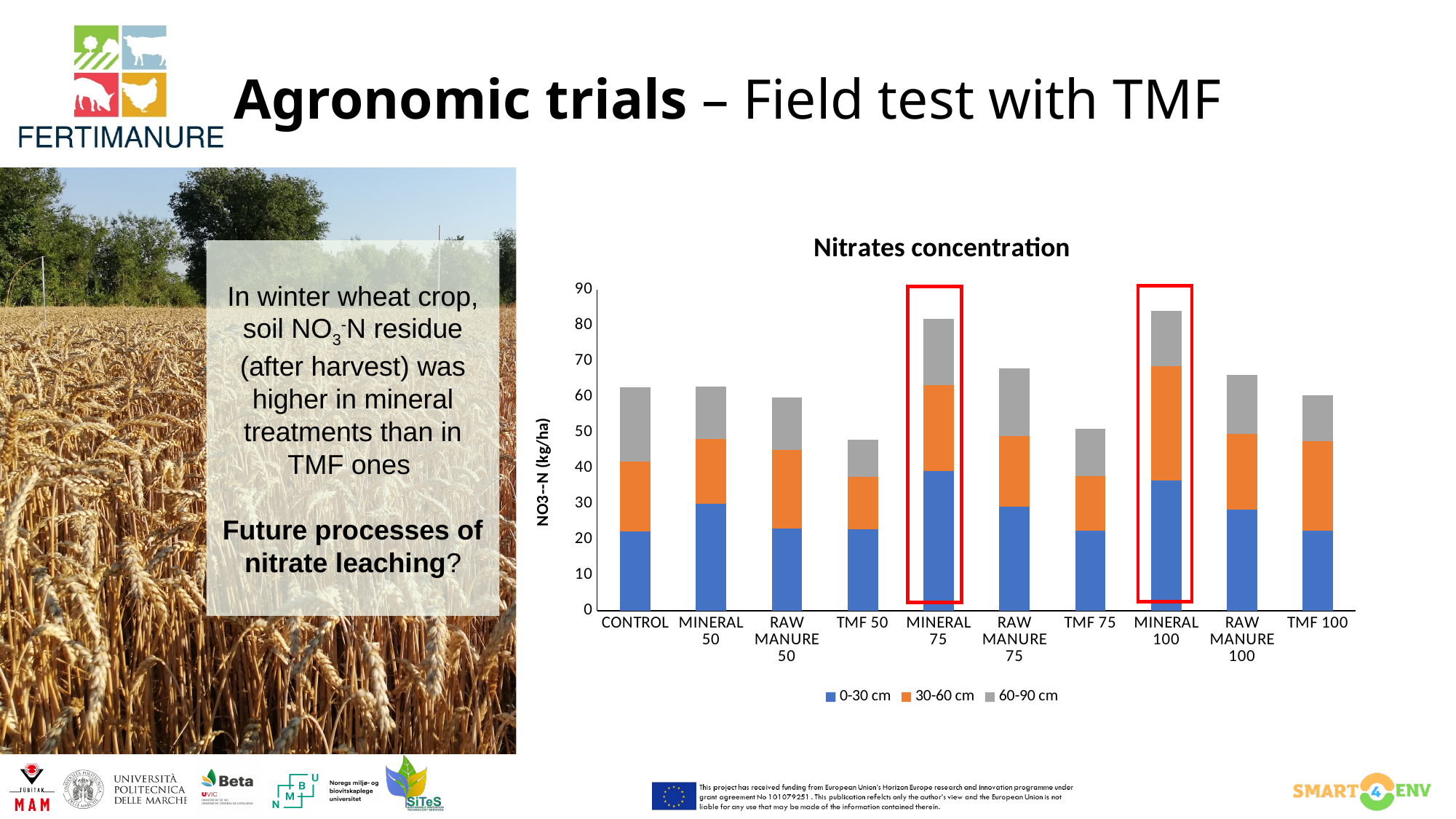
Which has the larger 0-30 cm segment, MINERAL 75 or CONTROL? MINERAL 75 What is the title of the chart? Nitrates concentration Which has the larger total bar, MINERAL 100 or TMF 100? MINERAL 100 Is the total bar height for TMF 50 greater or less than 60? less Is the total bar height for CONTROL greater or less than 50? greater Which two categories are highlighted with red boxes on the chart? MINERAL 75 and MINERAL 100 How many series does the chart legend list? 3 Which has the larger total bar, MINERAL 75 or TMF 75? MINERAL 75 How many treatment categories are shown on the x axis of the chart? 10 Is the total bar height for MINERAL 75 greater or less than 70? greater What kind of chart is shown on the slide? Stacked bar chart